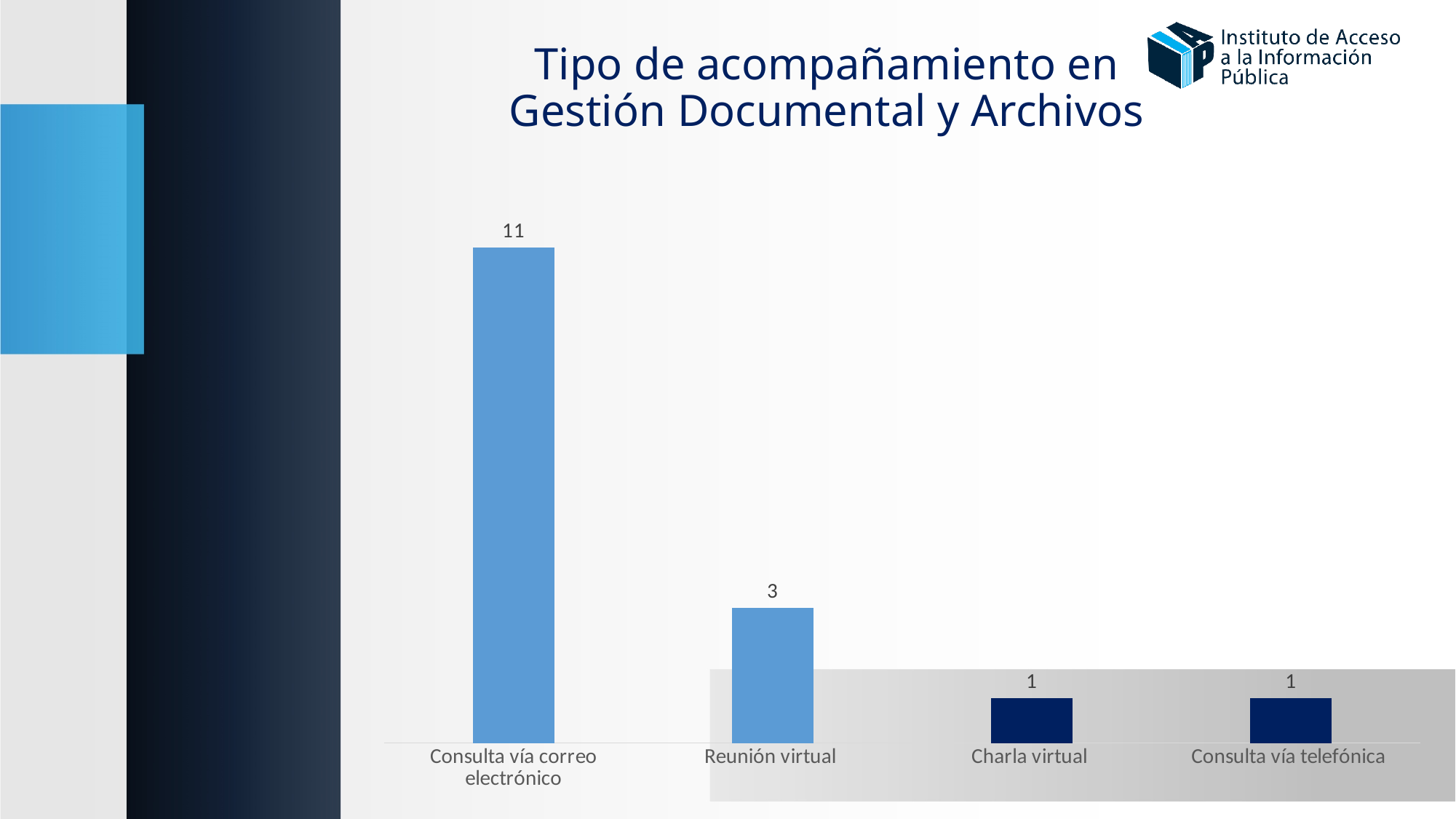
What is the title of the chart on the slide? Tipo de acompañamiento en Gestión Documental y Archivos What is the value for Charla virtual? 1 Which is larger, the value for Reunión virtual or the value for Consulta vía telefónica? Reunión virtual Which category has the highest value? Consulta vía correo electrónico What is the value for Consulta vía telefónica? 1 What is the value for Reunión virtual? 3 What kind of chart is shown on the slide? Bar chart What is the difference between the values for Consulta vía correo electrónico and Reunión virtual? 8 How many categories are shown in the chart? 4 What is the difference between the values for Reunión virtual and Charla virtual? 2 Do the values rise or fall from left to right across the categories? Fall What is the value for Consulta vía correo electrónico? 11